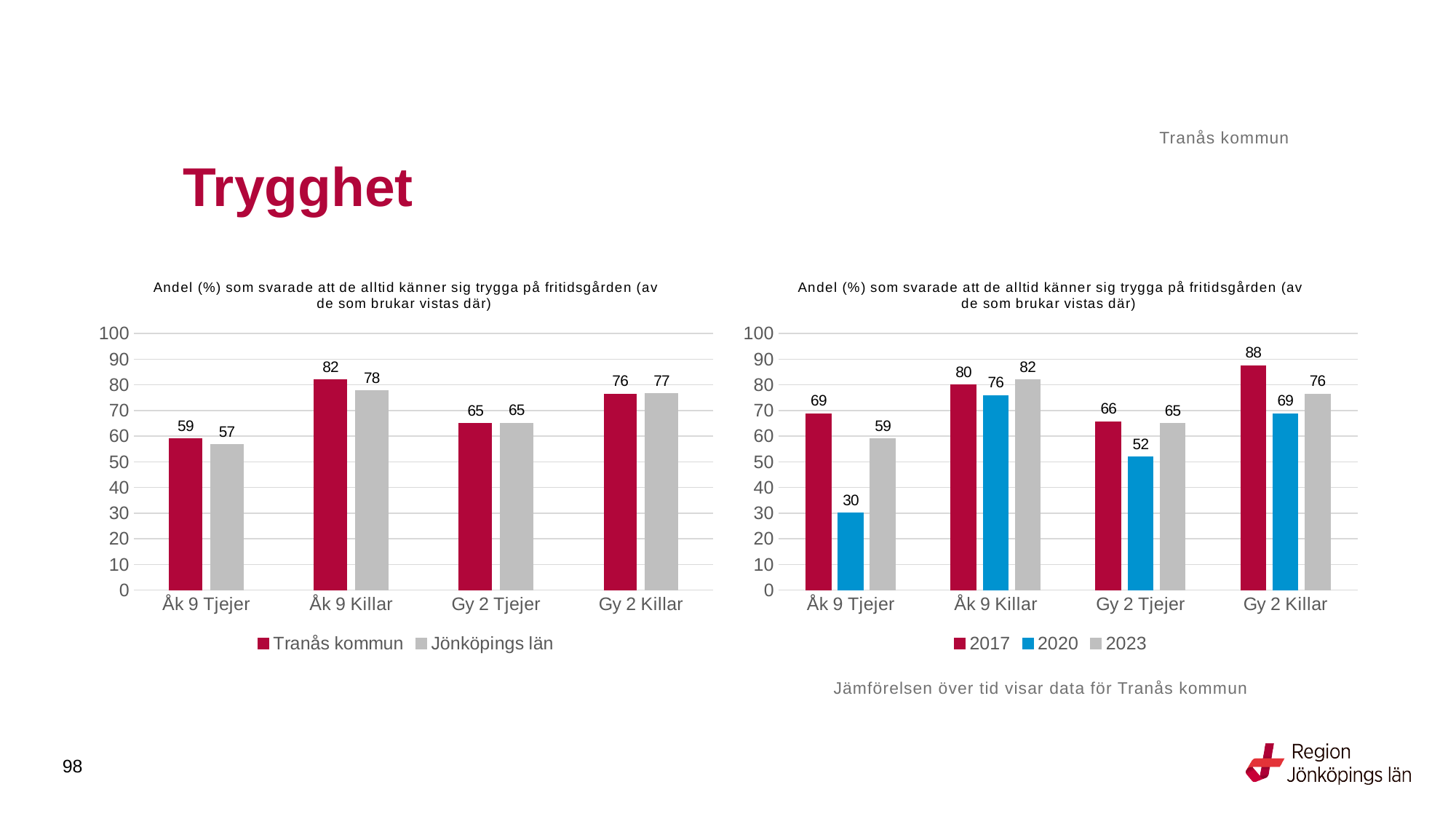
In the right chart, what is the difference between the 2017 and 2020 values for Åk 9 Tjejer? 39 In the left chart, what is the difference between Tranås kommun and Jönköpings län for Åk 9 Killar? 4 In the left chart, what is the value for Jönköpings län for Gy 2 Killar? 77 In the right chart, how many categories are shown on the x axis? 4 In the right chart, what is the 2023 value for Gy 2 Killar? 76 In the left chart, what is the value for Tranås kommun for Åk 9 Killar? 82 In the left chart, how many series does the legend list? 2 What type of chart is the right chart? Bar chart In the right chart, which category has the highest 2017 value? Gy 2 Killar In the right chart, which is larger for Gy 2 Tjejer: the 2017 value or the 2023 value? 2017 In the left chart, which category has the lowest value for Tranås kommun? Åk 9 Tjejer In the right chart, what is the 2020 value for Åk 9 Tjejer? 30